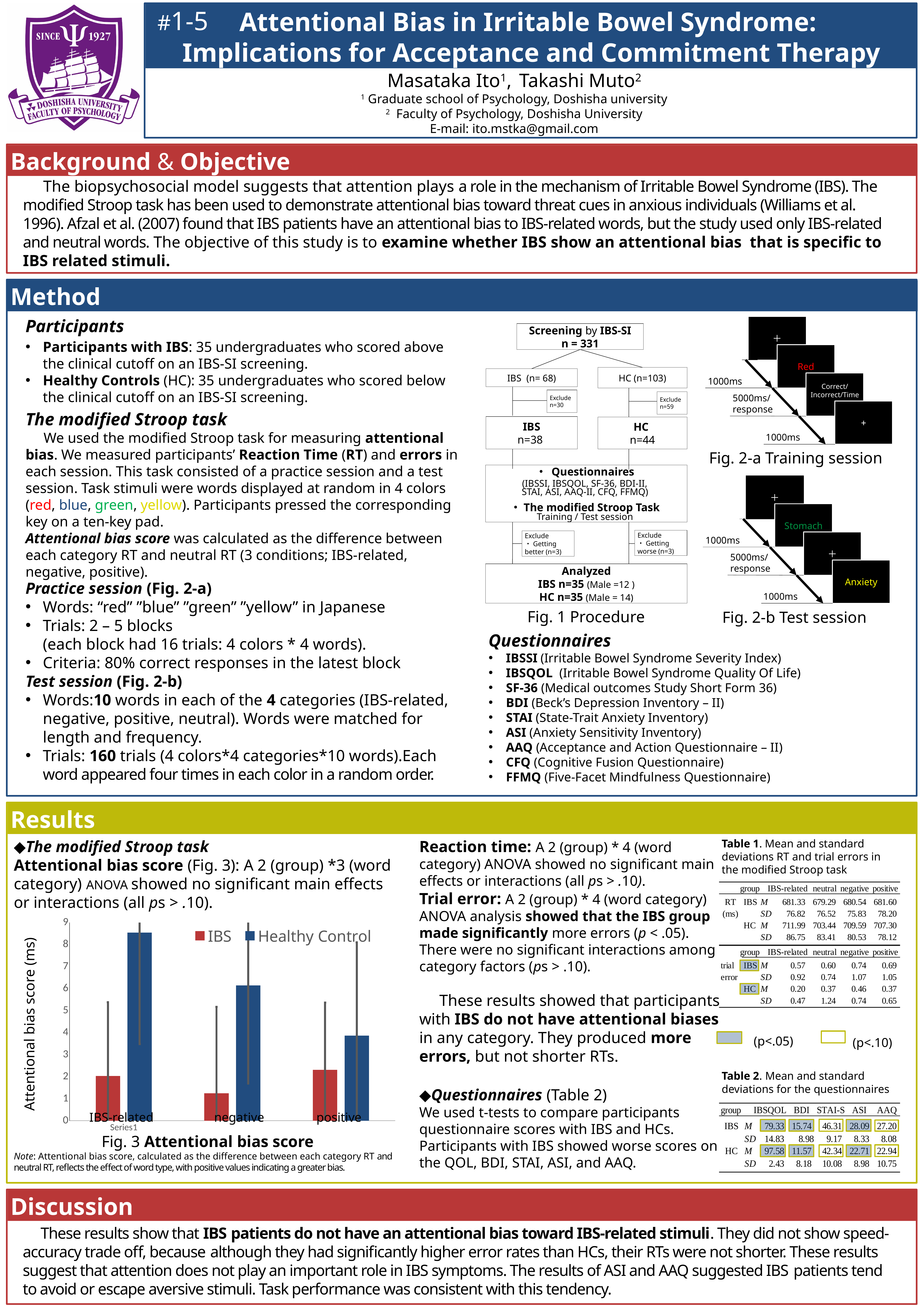
In Fig. 3, is the Healthy Control value for IBS-related greater or less than 8? greater In Fig. 3, is the Healthy Control value for negative greater or less than 5? greater In Fig. 3, do the Healthy Control bars rise or fall from IBS-related to positive along the x axis? fall What kind of chart is Fig. 3 Attentional bias score? bar chart In Fig. 3, which group and category has the highest attentional bias score? Healthy Control, IBS-related How many series does the legend of Fig. 3 list? 2 In Fig. 3, for the IBS-related category, which group has the larger attentional bias score? Healthy Control In Fig. 3, for the positive category, is the IBS bar or the Healthy Control bar taller? Healthy Control How many word categories are shown on the x axis of Fig. 3? 3 In Fig. 3, is the IBS value for IBS-related greater or less than 3? less In Fig. 3, which category has the lowest bar for the IBS group? negative In Fig. 3, what colour represents the IBS group? red